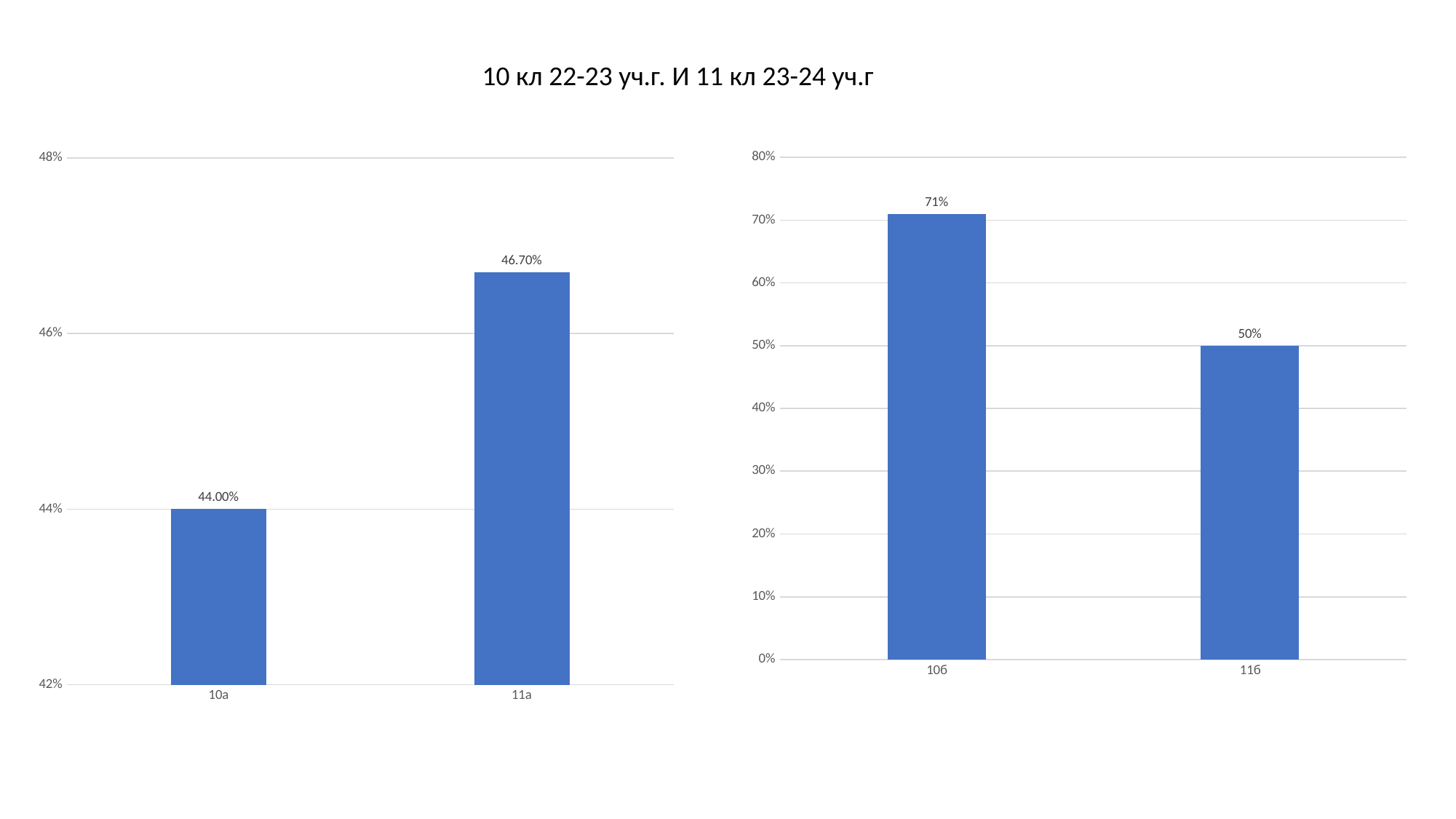
In the left chart, which category has the higher value? 11а In the right chart, what is the value for 10б? 71% In the left chart, what is the difference between the values for 11а and 10а? 2.70% In the right chart, what is the value for 11б? 50% What type of chart is the right chart? bar chart In the right chart, is the value for 10б greater or less than 60%? greater What is the title shown at the top of the slide? 10 кл 22-23 уч.г. И 11 кл 23-24 уч.г How many bars are in the left chart? 2 In the right chart, what is the difference between the values for 10б and 11б? 21% In the left chart, what is the value for 11а? 46.70% In the left chart, what is the value for 10а? 44.00% In the right chart, which category has the lower value? 11б